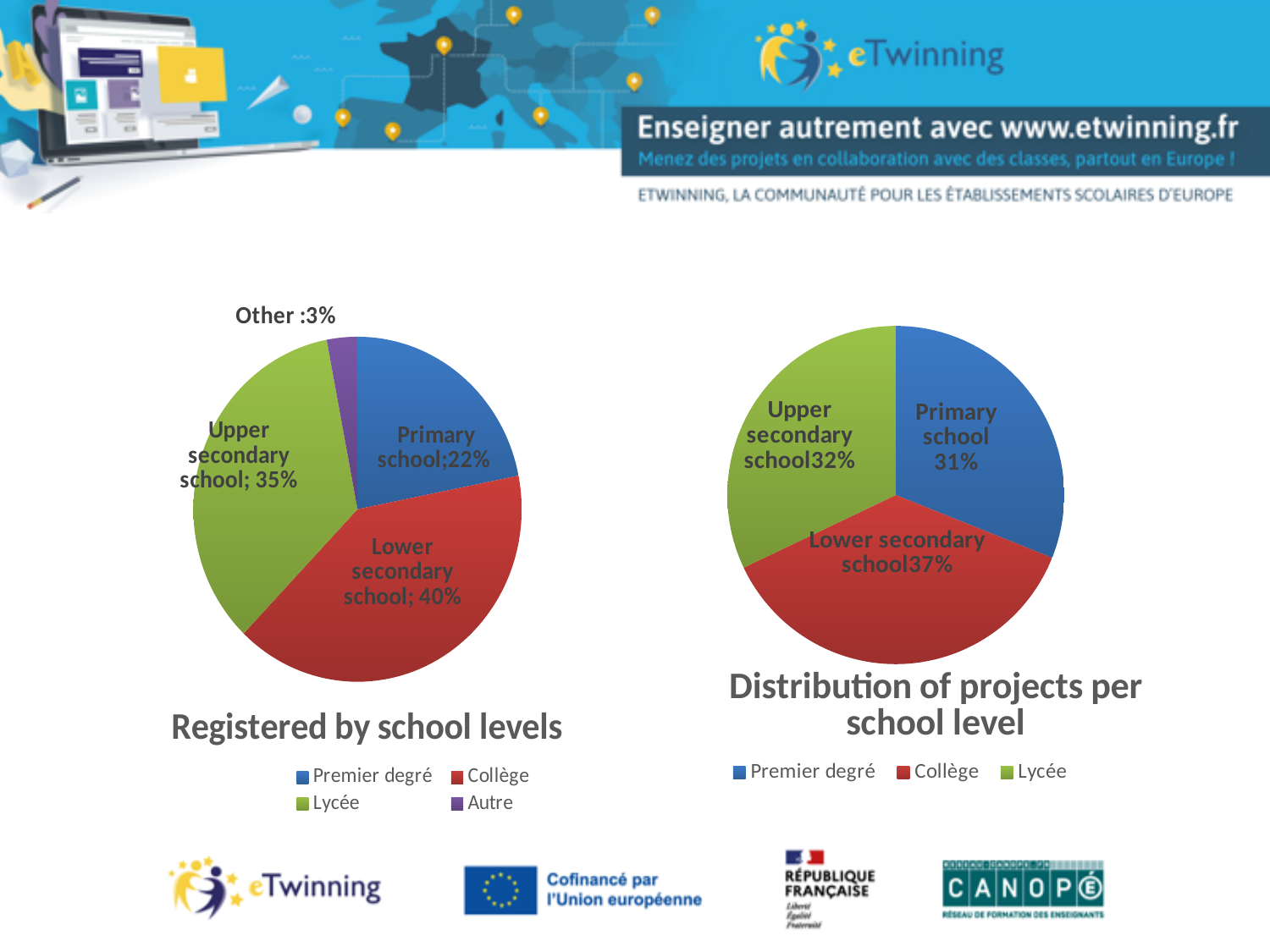
In the 'Distribution of projects per school level' chart, which category has the largest share? Lower secondary school In the 'Registered by school levels' chart, what share is Other? 3% In the 'Distribution of projects per school level' chart, what share is Lower secondary school? 37% What type of chart is 'Distribution of projects per school level'? Pie chart In the 'Distribution of projects per school level' chart, how many categories are shown? 3 In the 'Registered by school levels' chart, which category has the largest share? Lower secondary school In the 'Registered by school levels' chart, what share is Primary school? 22% In the 'Registered by school levels' chart, which category has the smallest share? Other In the 'Registered by school levels' chart, what is the difference between Upper secondary school and Primary school? 13% In the 'Registered by school levels' chart, what share is Lower secondary school? 40% How many entries does the legend of the 'Registered by school levels' chart list? 4 In the 'Distribution of projects per school level' chart, what share is Upper secondary school? 32%